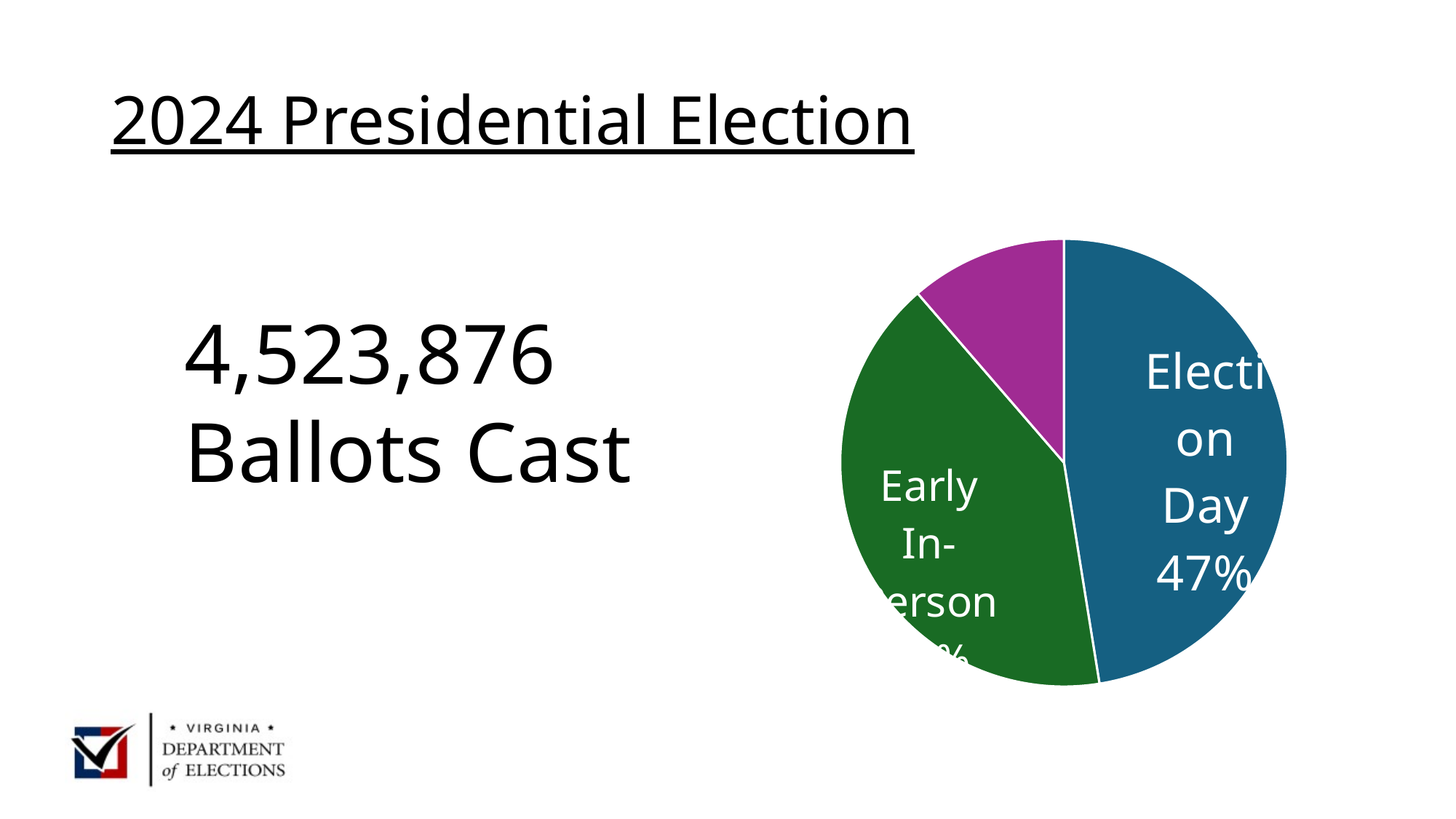
Which is larger, the Election Day slice or the Early In-Person slice? Election Day Is the share for Election Day greater or less than 50%? less How many slices does the pie chart have? 3 Is the share for Early In-Person greater or less than 50%? less Which labelled slice of the pie chart is the largest? Election Day What kind of chart is shown on the slide? pie chart What colour is the Election Day slice of the pie chart? blue Is the share for Early In-Person greater or less than 25%? greater What share of ballots does the Election Day slice represent? 47% What colour is the Early In-Person slice of the pie chart? green